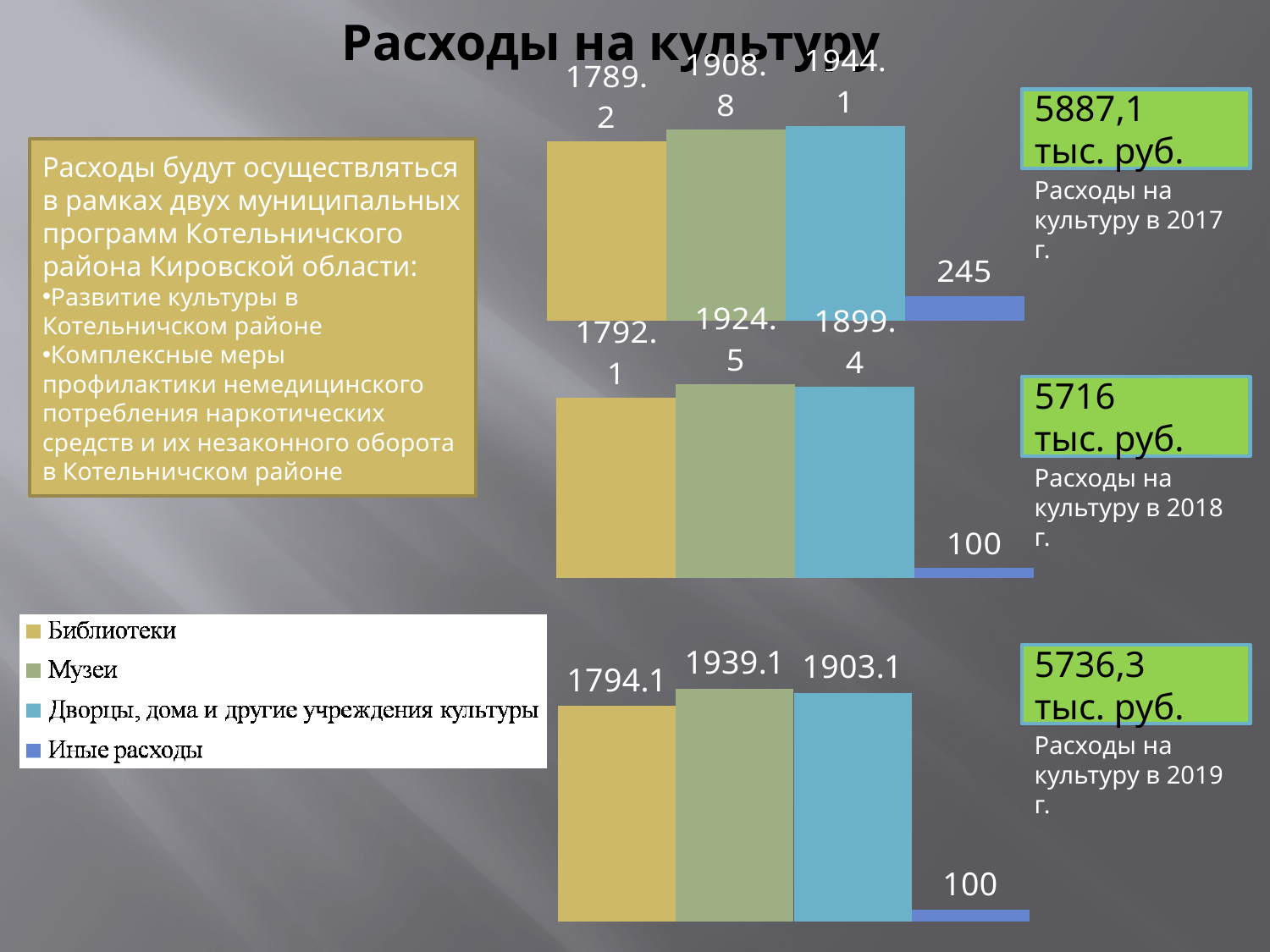
In the top chart (Расходы на культуру в 2017 г.), what is the value for Библиотеки? 1789.2 In the top chart (Расходы на культуру в 2017 г.), what is the value for Иные расходы? 245 In the middle chart (Расходы на культуру в 2018 г.), which is larger: Музеи or Дворцы, дома и другие учреждения культуры? Музеи In the top chart (Расходы на культуру в 2017 г.), which category has the highest value? Дворцы, дома и другие учреждения культуры In the bottom chart (Расходы на культуру в 2019 г.), what is the value for Дворцы, дома и другие учреждения культуры? 1903.1 What type of chart is used to show the expenses for each year? Bar chart In the top chart (Расходы на культуру в 2017 г.), what is the difference between Дворцы, дома и другие учреждения культуры and Музеи? 35.3 How many categories does the legend list for the charts? 4 In the bottom chart (Расходы на культуру в 2019 г.), which category has the highest value? Музеи In the middle chart (Расходы на культуру в 2018 г.), which category has the lowest value? Иные расходы In the bottom chart (Расходы на культуру в 2019 г.), what is the difference between Музеи and Библиотеки? 145 In the middle chart (Расходы на культуру в 2018 г.), what is the value for Музеи? 1924.5